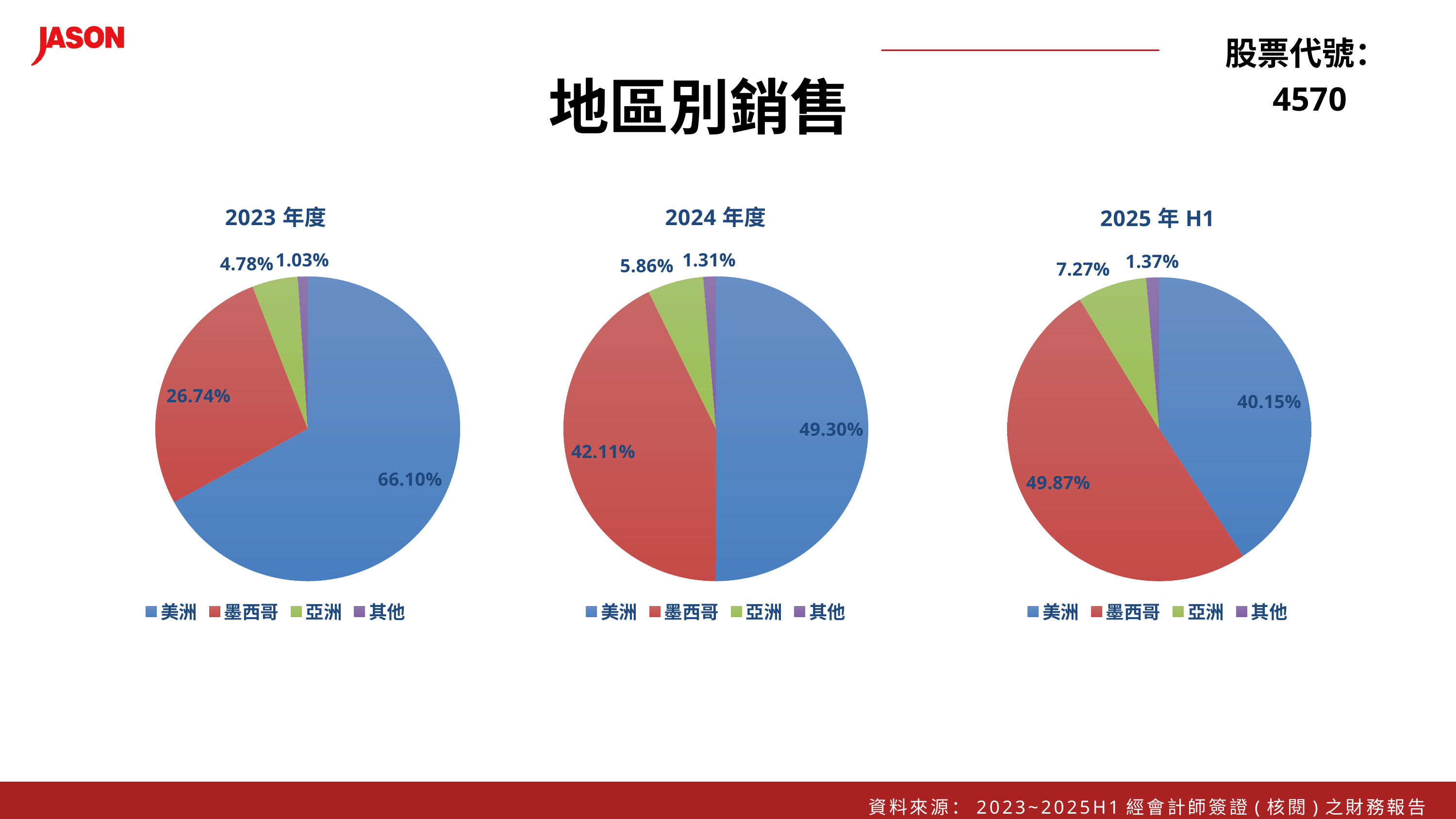
What kind of chart is used for 2025 年 H1? Pie chart In the 2025 年 H1 pie chart, what share does 亞洲 have? 7.27% In the 2023 年度 pie chart, which is larger, the share of 墨西哥 or the share of 亞洲? 墨西哥 In the 2023 年度 pie chart, which region has the smallest share? 其他 How many slices does the 2024 年度 pie chart have? 4 In the 2025 年 H1 pie chart, what share does 其他 have? 1.37% In the 2024 年度 pie chart, what is the difference between the shares of 美洲 and 墨西哥? 7.19% In the 2024 年度 pie chart, what share does 墨西哥 have? 42.11% In the 2025 年 H1 pie chart, which region has the largest share? 墨西哥 In the 2023 年度 pie chart, what share does 美洲 have? 66.10% How many entries does the legend of the 2023 年度 chart list? 4 What colour represents 亞洲 in the pie charts? Green